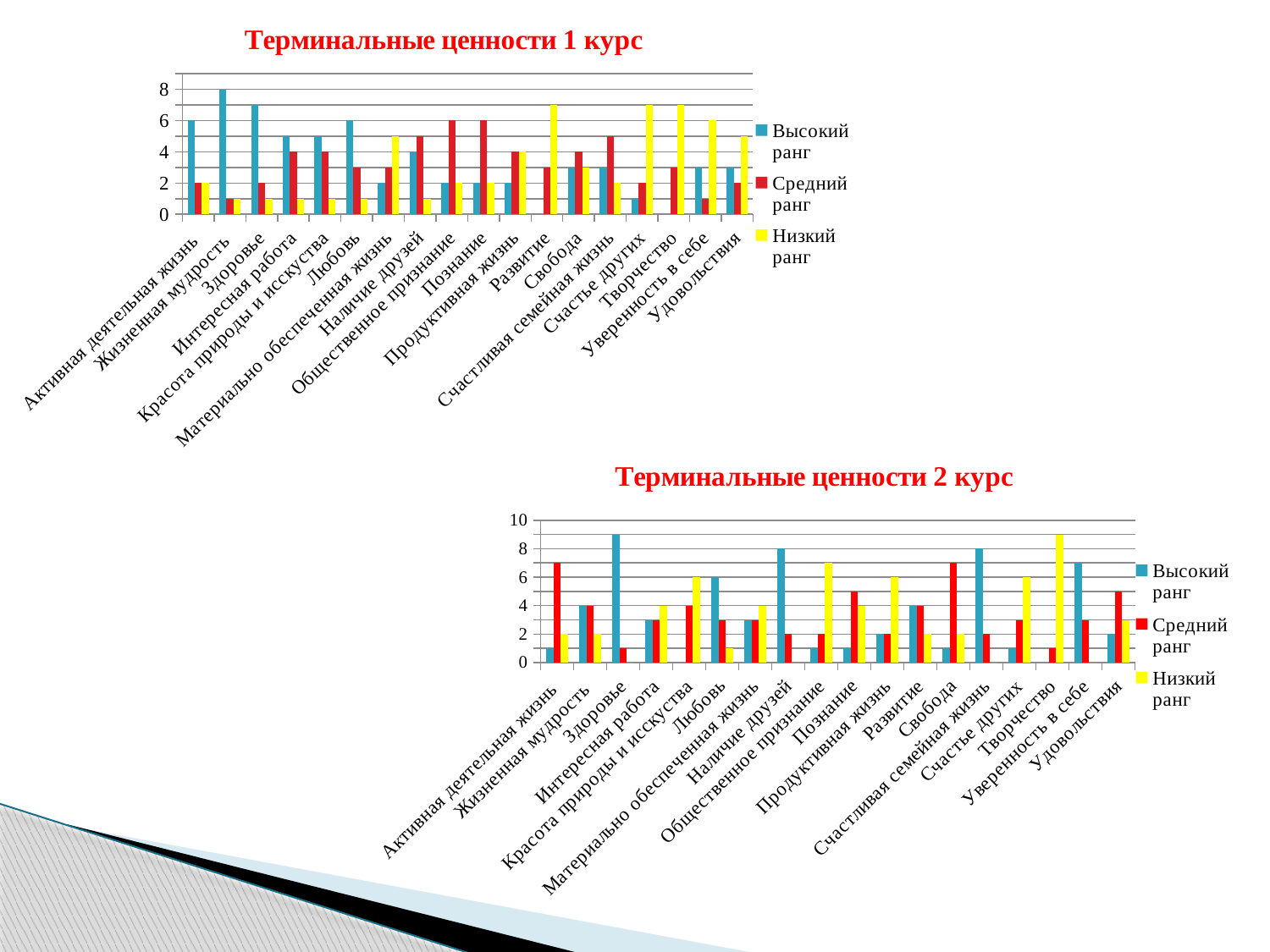
In the chart titled 'Терминальные ценности 1 курс', how many series does the legend list? 3 In the chart titled 'Терминальные ценности 1 курс', which category has the highest 'Высокий ранг' value? Жизненная мудрость In the chart titled 'Терминальные ценности 1 курс', is the 'Высокий ранг' value for 'Здоровье' greater or less than 6? greater In the chart titled 'Терминальные ценности 1 курс', what is the value of 'Высокий ранг' for 'Активная деятельная жизнь'? 6 In the chart titled 'Терминальные ценности 2 курс', what is the value of 'Высокий ранг' for 'Наличие друзей'? 8 In the chart titled 'Терминальные ценности 2 курс', which is larger for 'Здоровье': 'Высокий ранг' or 'Средний ранг'? Высокий ранг In the chart titled 'Терминальные ценности 1 курс', how many categories are shown on the x axis? 18 In the chart titled 'Терминальные ценности 2 курс', is the 'Низкий ранг' value for 'Творчество' greater or less than 8? greater What type of chart is 'Терминальные ценности 2 курс'? bar chart In the chart titled 'Терминальные ценности 1 курс', what is the difference between the 'Высокий ранг' values for 'Жизненная мудрость' and 'Активная деятельная жизнь'? 2 In the chart titled 'Терминальные ценности 2 курс', which category has the highest 'Высокий ранг' value? Здоровье In the chart titled 'Терминальные ценности 1 курс', what is the value of 'Высокий ранг' for 'Жизненная мудрость'? 8